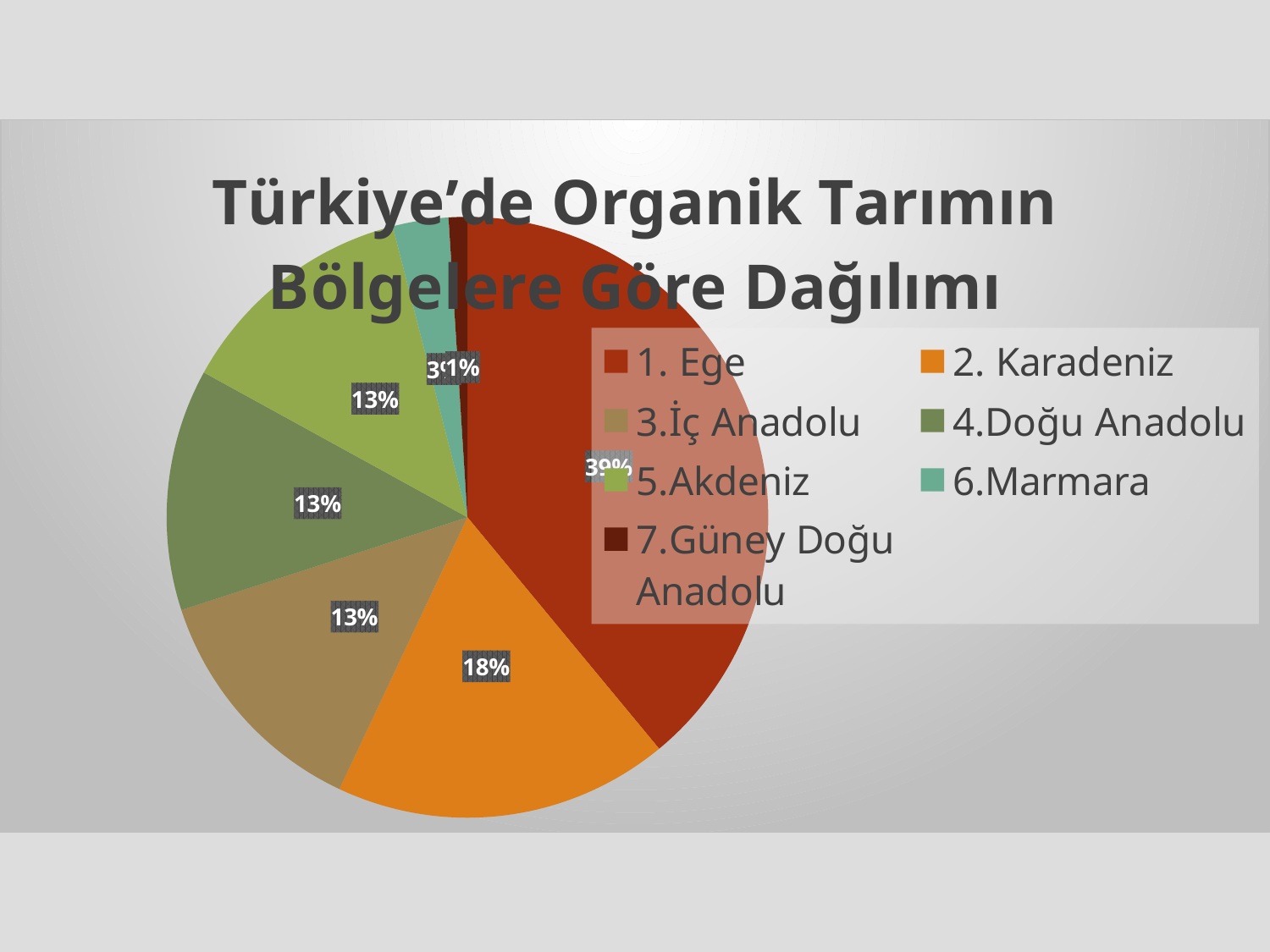
Which region has the smallest slice of the pie? 7.Güney Doğu Anadolu How many regions (slices) does the pie chart show? 7 How many entries does the legend list? 7 Which is larger, the share for 2. Karadeniz or the share for 4.Doğu Anadolu? 2. Karadeniz Which region has the largest slice of the pie? 1. Ege What type of chart is shown on the slide? Pie chart What is the title of the chart? Türkiye'de Organik Tarımın Bölgelere Göre Dağılımı What share of the pie does 1. Ege have? 39% What colour is the slice for 2. Karadeniz? Orange What is the value shown for 2. Karadeniz? 18% What is the value shown for 3.İç Anadolu? 13% What is the difference in percentage points between 1. Ege and 2. Karadeniz? 21 percentage points